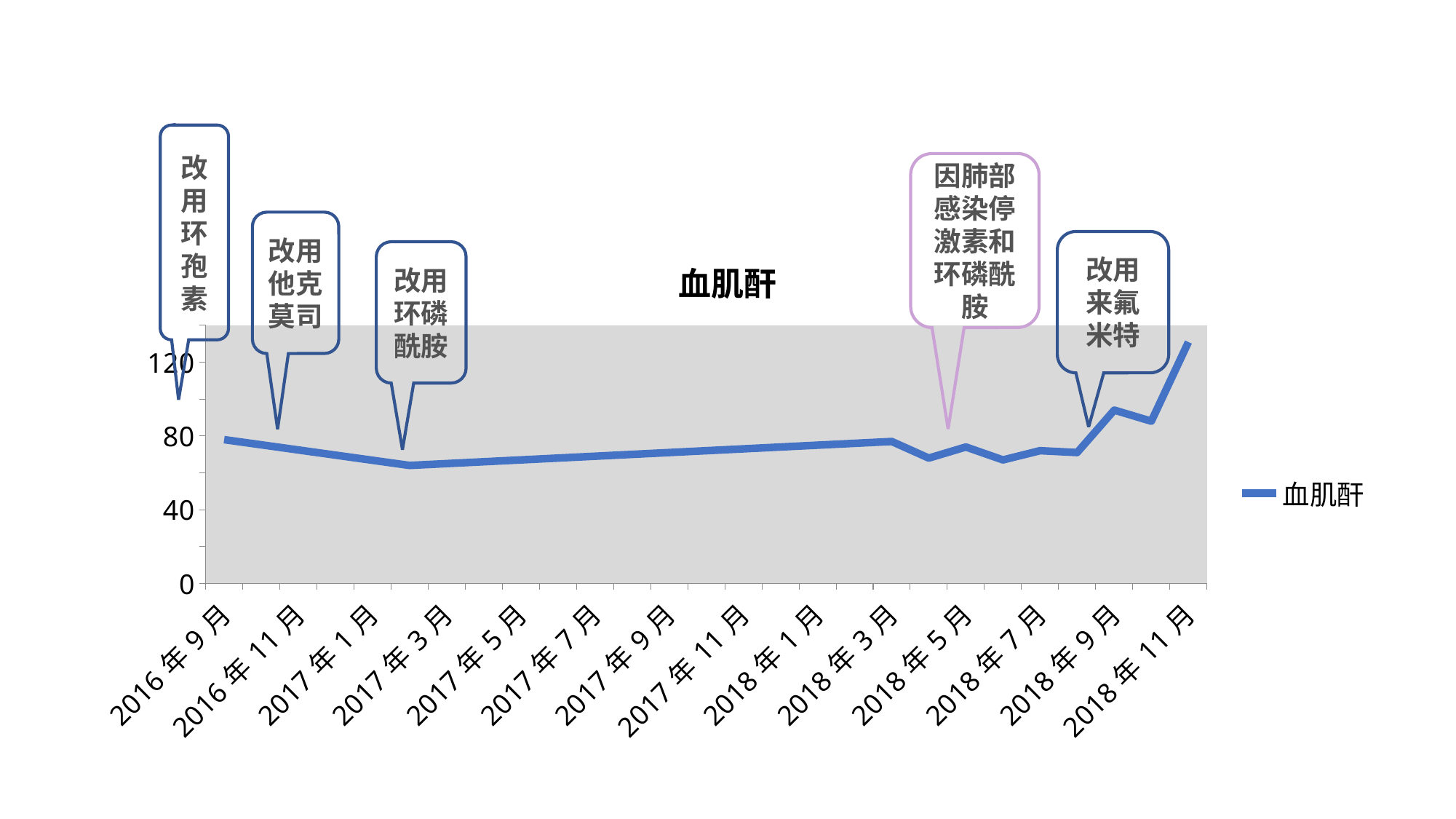
Is the value for 2018年11月 greater or less than 120? greater What is the title of the chart? 血肌酐 Is the value for 2018年9月 greater or less than 80? greater Which is larger, the value for 2018年11月 or the value for 2017年3月? 2018年11月 Is the value for 2017年3月 greater or less than 80? less Does the 血肌酐 line rise or fall from 2016年9月 to 2017年3月? fall What colour is the 血肌酐 line? blue What kind of chart is shown on the slide? line chart Does the 血肌酐 line rise or fall from 2018年9月 to 2018年11月? rise Which month has the highest 血肌酐 value? 2018年11月 How many series does the legend list? 1